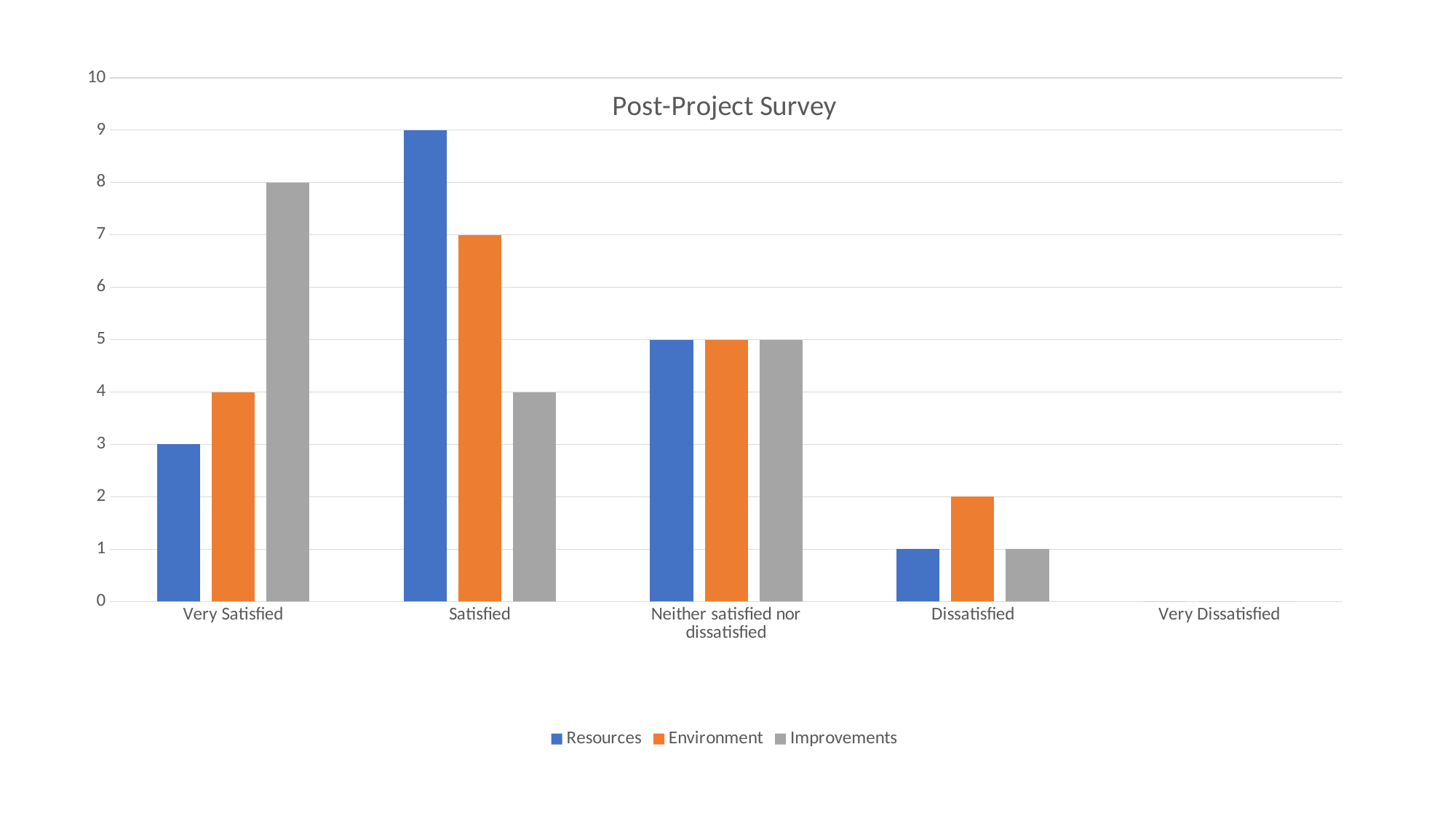
What is the difference between the Resources and Improvements values in the Satisfied category? 5 What is the value for Resources in the Satisfied category? 9 How many series does the legend list? 3 In the Very Satisfied category, which is larger: Resources or Environment? Environment In which category does the Improvements series reach its lowest value? Very Dissatisfied What type of chart is shown on the slide? Bar chart What is the value for Environment in the Dissatisfied category? 2 How many categories are shown on the x axis? 5 What is the value for Improvements in the Very Satisfied category? 8 Is the value for Environment in the Satisfied category greater or less than 5? greater In which category does the Resources series reach its highest value? Satisfied What is the title of the chart? Post-Project Survey